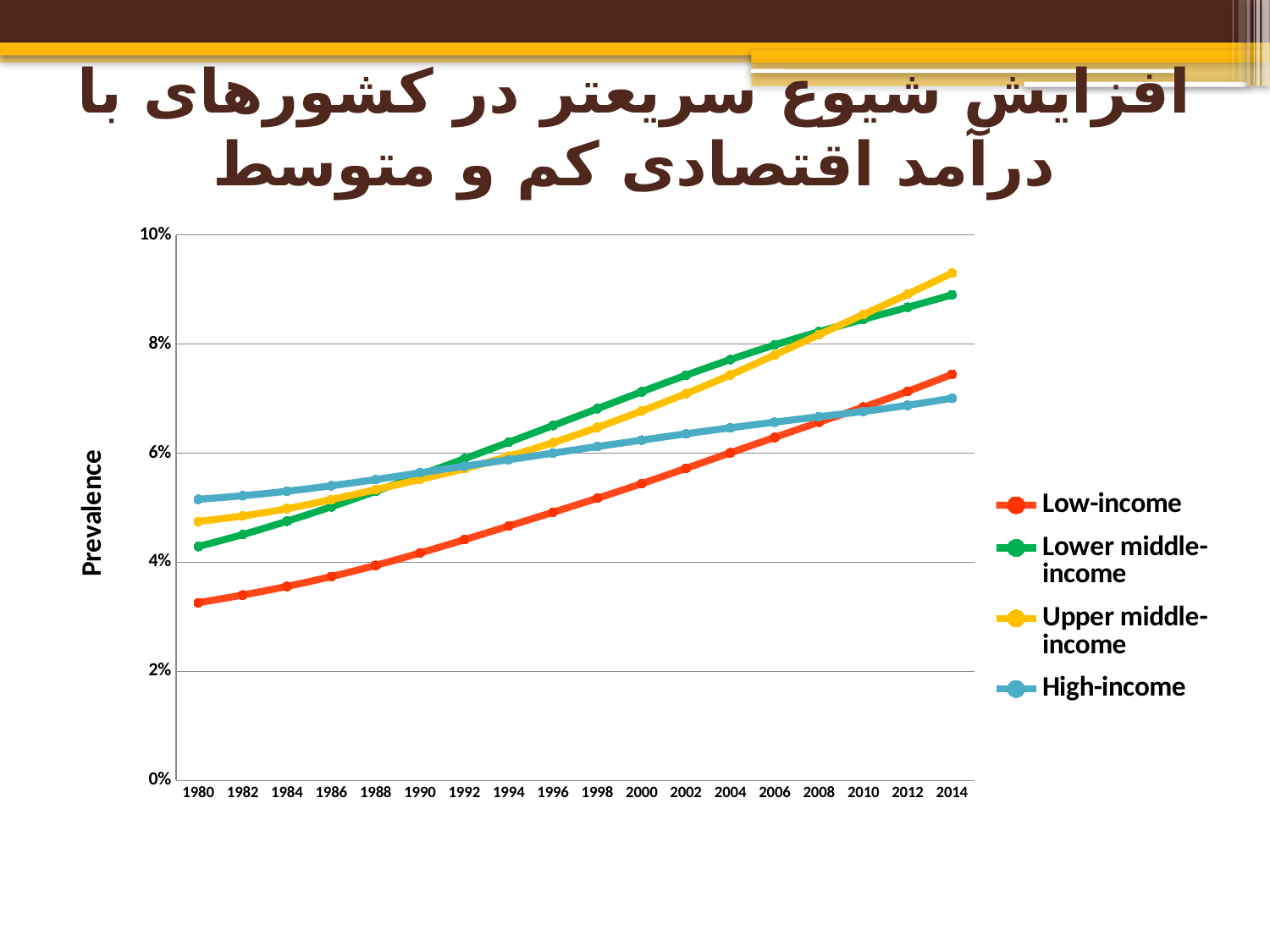
Which series has the highest prevalence in 1980? High-income How many series does the legend list? 4 What is the label on the y axis? Prevalence How many years are labelled along the x axis? 18 Which series has the lowest prevalence in 2014? High-income Is the value for High-income in 2014 greater or less than 6%? greater Is the value for Upper middle-income in 2014 greater or less than 8%? greater In 2000, which is larger: the value for Lower middle-income or the value for Low-income? Lower middle-income Does the Low-income line rise or fall from 1980 to 2014? rises Which series has the lowest prevalence in 1980? Low-income Is the value for Low-income in 1980 greater or less than 4%? less What kind of chart is shown on the slide? line chart